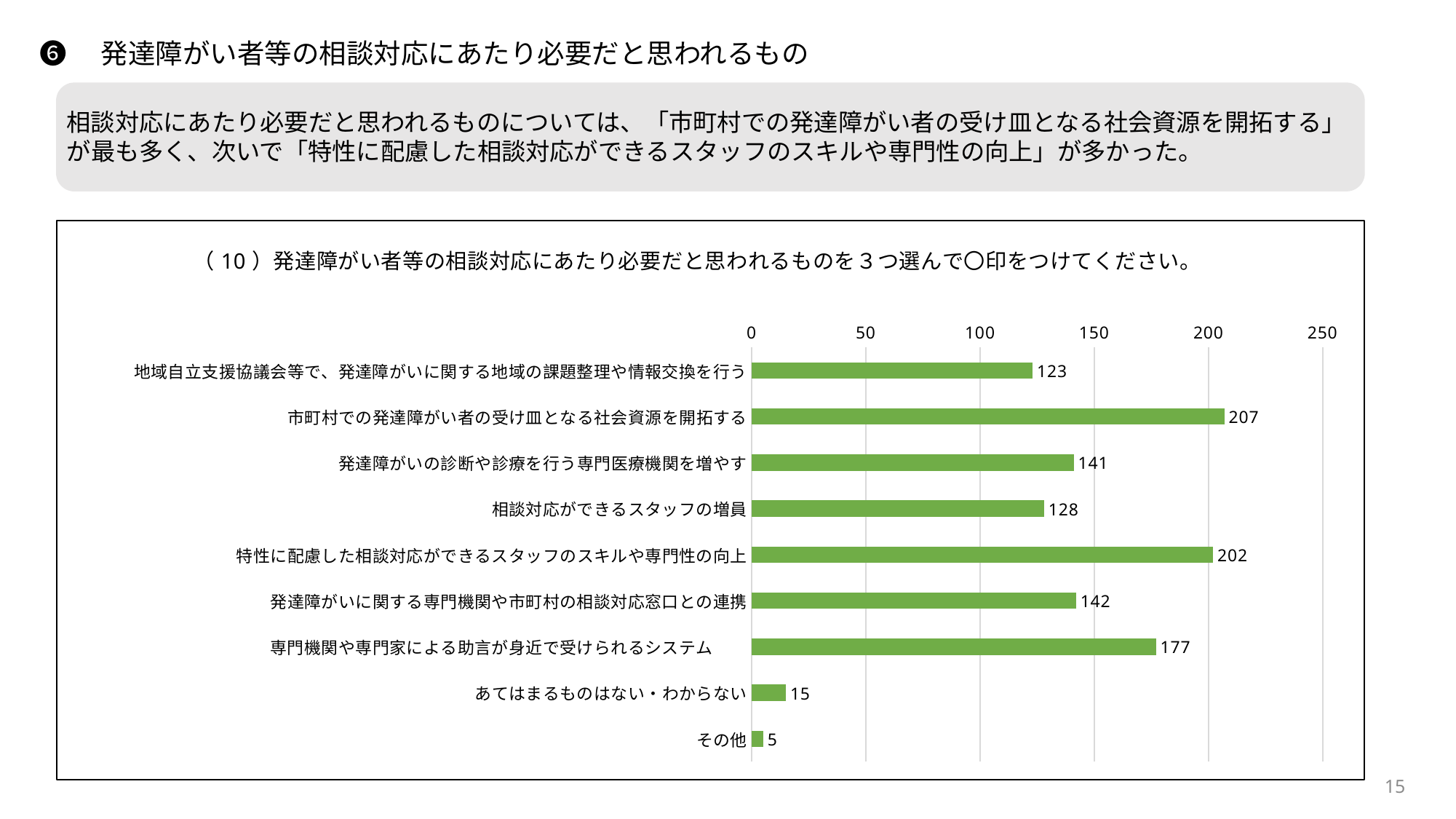
Which category has the highest value? 市町村での発達障がい者の受け皿となる社会資源を開拓する What is the value for あてはまるものはない・わからない? 15 What is the maximum value shown on the horizontal axis? 250 What is the value for 専門機関や専門家による助言が身近で受けられるシステム? 177 What is the value for 相談対応ができるスタッフの増員? 128 Is the value for 専門機関や専門家による助言が身近で受けられるシステム greater or less than 150? greater Which is larger: the value for 発達障がいの診断や診療を行う専門医療機関を増やす or the value for 地域自立支援協議会等で、発達障がいに関する地域の課題整理や情報交換を行う? 発達障がいの診断や診療を行う専門医療機関を増やす What is the value for 市町村での発達障がい者の受け皿となる社会資源を開拓する? 207 What kind of chart is shown on the slide? Bar chart Which category has the lowest value? その他 How many categories are shown in the chart? 9 What is the difference between the values for 市町村での発達障がい者の受け皿となる社会資源を開拓する and 特性に配慮した相談対応ができるスタッフのスキルや専門性の向上? 5